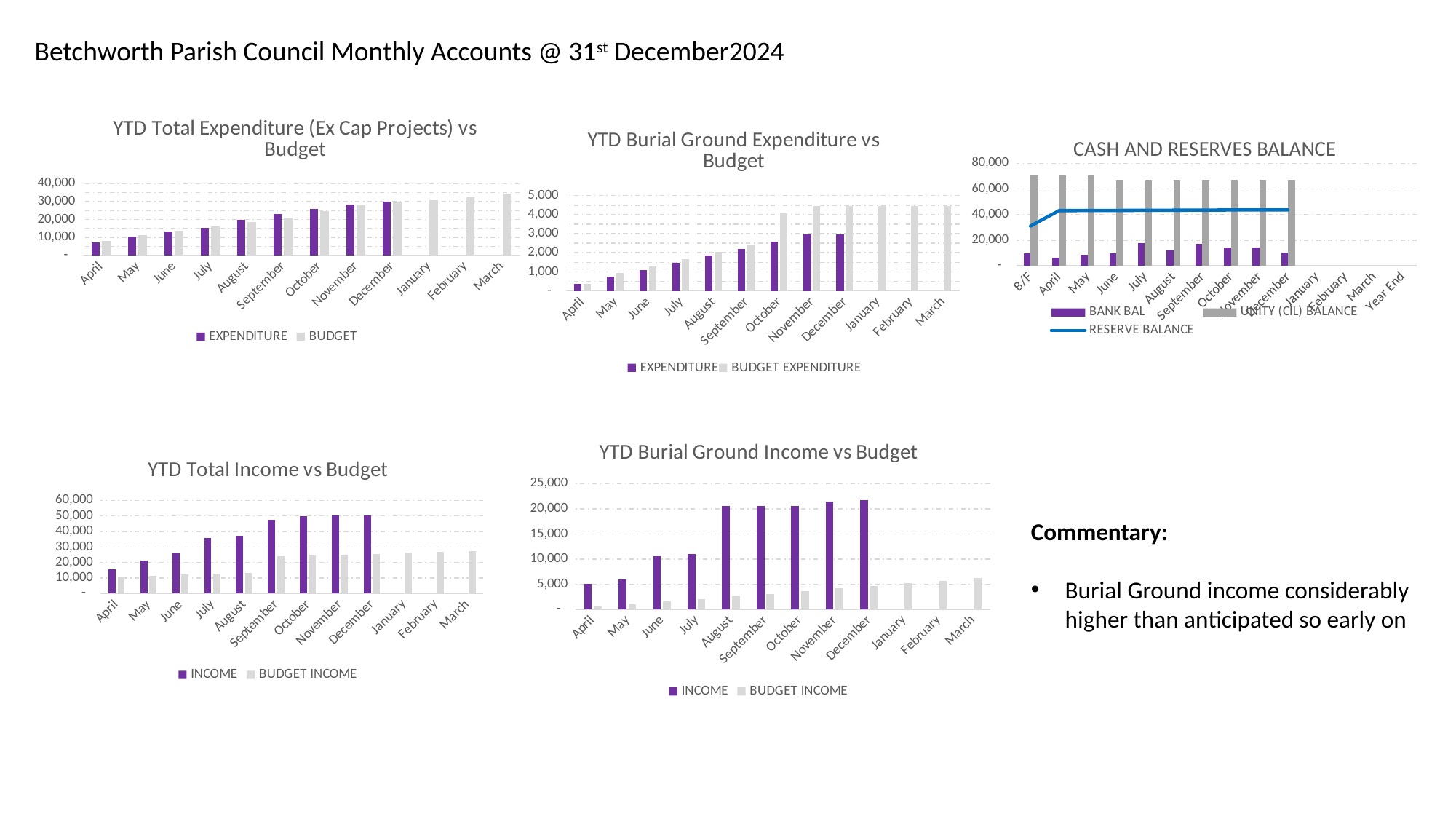
How many months are shown on the x axis of the 'YTD Burial Ground Expenditure vs Budget' chart? 12 In the 'YTD Total Income vs Budget' chart, is the INCOME value for October greater or less than 40,000? greater In the 'YTD Total Expenditure (Ex Cap Projects) vs Budget' chart, is the EXPENDITURE value for December greater or less than 20,000? greater In the 'YTD Total Income vs Budget' chart, which is larger for December: INCOME or BUDGET INCOME? INCOME In the 'YTD Burial Ground Expenditure vs Budget' chart, is the EXPENDITURE value for November greater or less than 2,000? greater How many series does the legend of the 'CASH AND RESERVES BALANCE' chart list? 3 In the 'YTD Total Expenditure (Ex Cap Projects) vs Budget' chart, does the EXPENDITURE series rise or fall from April to December? rise How many series does the legend of the 'YTD Total Expenditure (Ex Cap Projects) vs Budget' chart list? 2 What kind of chart is the 'YTD Total Expenditure (Ex Cap Projects) vs Budget' chart? bar chart